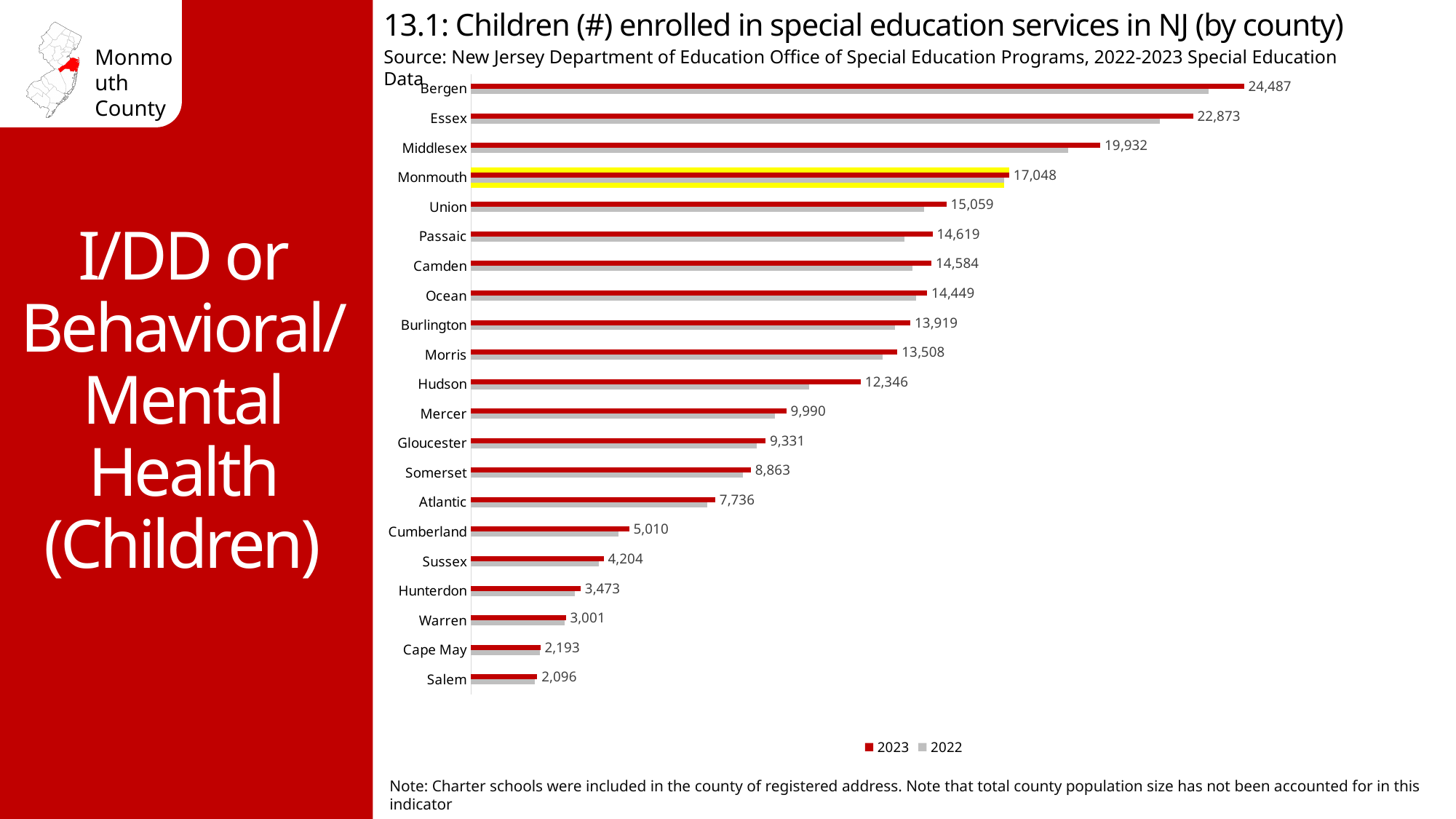
What is the 2023 value for Hudson? 12,346 Which has the larger 2023 value, Hudson or Mercer? Hudson What is the difference between the 2023 values for Monmouth and Union? 1,989 How many counties are shown in the chart? 21 For Hudson, which year has the larger value, 2023 or 2022? 2023 What is the 2023 value for Cumberland? 5,010 What kind of chart is shown? Bar chart What is the 2023 value for Monmouth? 17,048 Which county has the lowest 2023 value? Salem How many series does the legend list? 2 What is the difference between the 2023 values for Bergen and Essex? 1,614 Which county has the highest 2023 value? Bergen